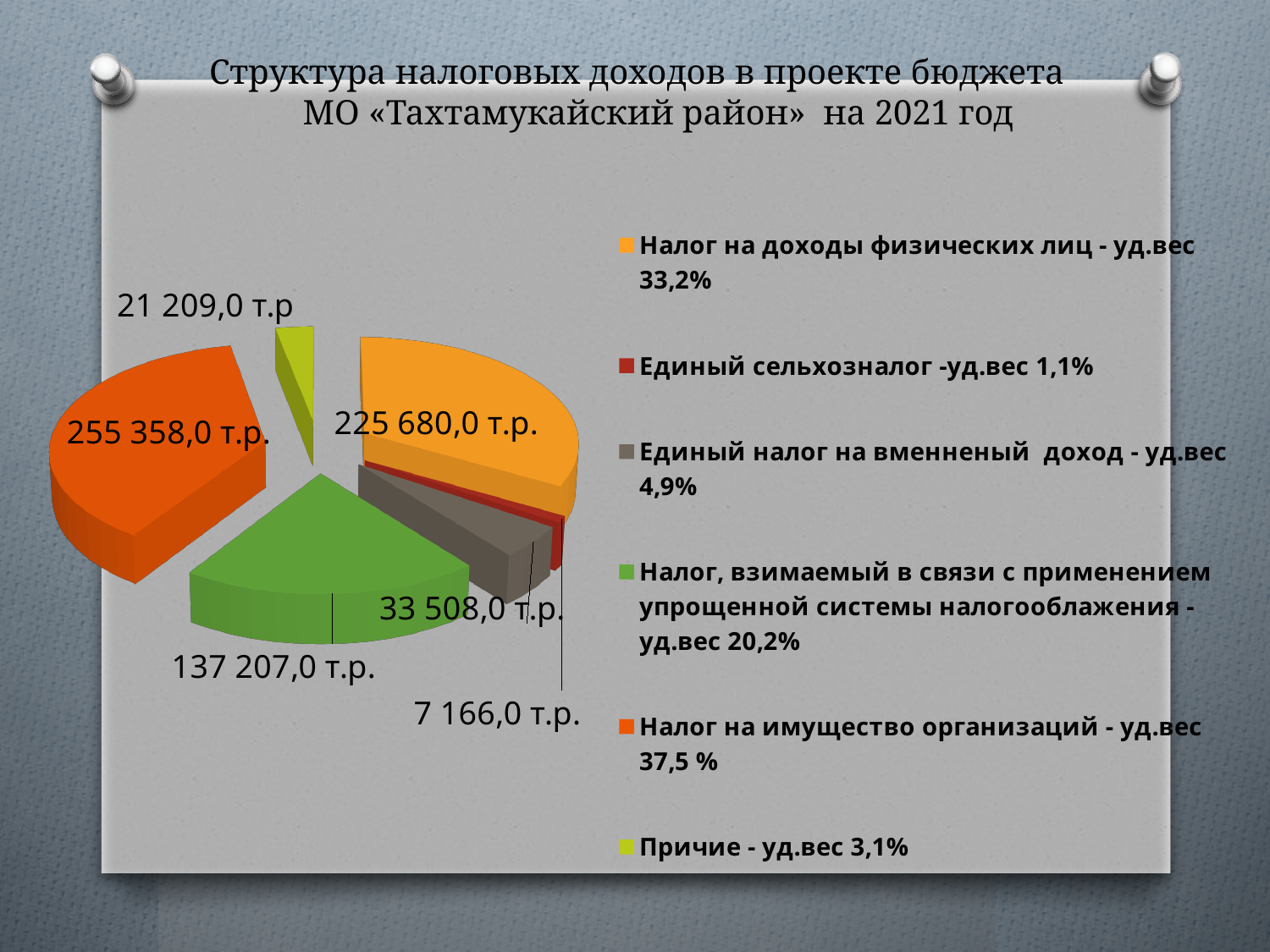
Какое значение указано для сектора «Единый сельхозналог»? 7 166,0 т.р. Какое значение указано для сектора «Налог, взимаемый в связи с применением упрощенной системы налогооблажения»? 137 207,0 т.р. Какой удельный вес указан в легенде для категории «Единый налог на вменненый доход»? 4,9% Какая категория имеет наименьшее значение на диаграмме? Единый сельхозналог Какая категория имеет наибольшее значение на диаграмме? Налог на имущество организаций Какой удельный вес указан в легенде для категории «Причие»? 3,1% На сколько значение «Налог на имущество организаций» больше значения «Налог на доходы физических лиц»? 29 678,0 т.р. Какое значение указано для сектора «Налог на доходы физических лиц»? 225 680,0 т.р. Какое значение указано для сектора «Налог на имущество организаций»? 255 358,0 т.р. Какой тип диаграммы показан на слайде? Круговая диаграмма Что больше: значение для «Налог на доходы физических лиц» или для «Налог, взимаемый в связи с применением упрощенной системы налогооблажения»? Налог на доходы физических лиц Сколько категорий (секторов) показано на круговой диаграмме? 6